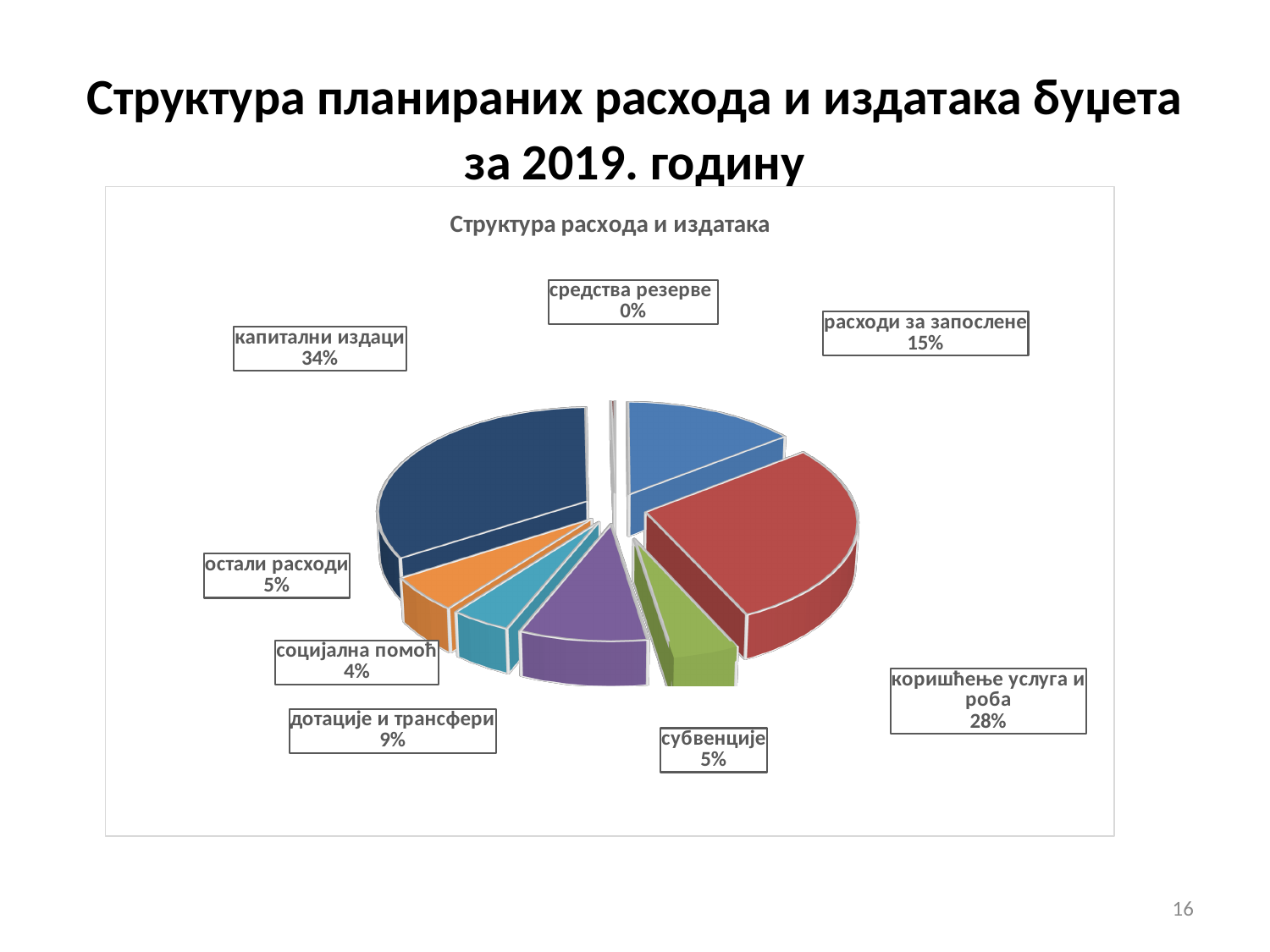
How many categories (slices) are labelled on the pie chart? 8 Which category has the smallest share of the pie? средства резерве Which category has the largest share of the pie? капитални издаци What share of the pie is labelled for капитални издаци? 34% What share of the pie is labelled for расходи за запослене? 15% What share of the pie is labelled for средства резерве? 0% What kind of chart is shown on the slide? pie chart What is the title of the chart? Структура расхода и издатака What is the difference in percentage points between капитални издаци and коришћење услуга и роба? 6 percentage points